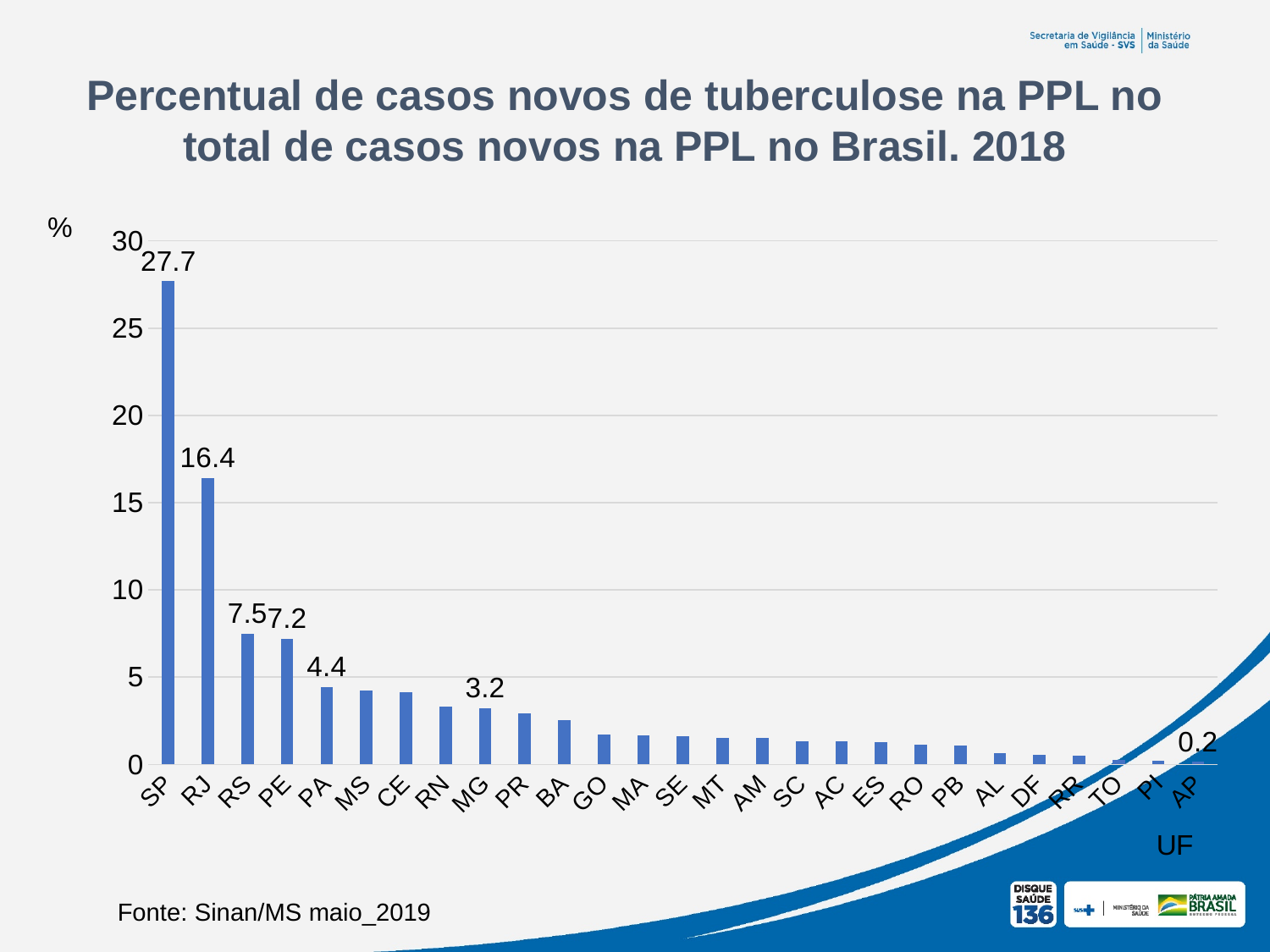
Is the value for CE greater or less than 5? less What is the value for MG? 3.2 Which UF has the highest value? SP Do the values rise or fall from left to right along the x axis? fall What is the value for SP? 27.7 What is the value for RJ? 16.4 What is the value for PA? 4.4 Is the value for MS greater or less than 5? less Which is larger, the value for RS or the value for PE? RS How many UFs are shown on the x axis? 27 What kind of chart is shown on the slide? bar chart What is the difference between the values for SP and RJ? 11.3